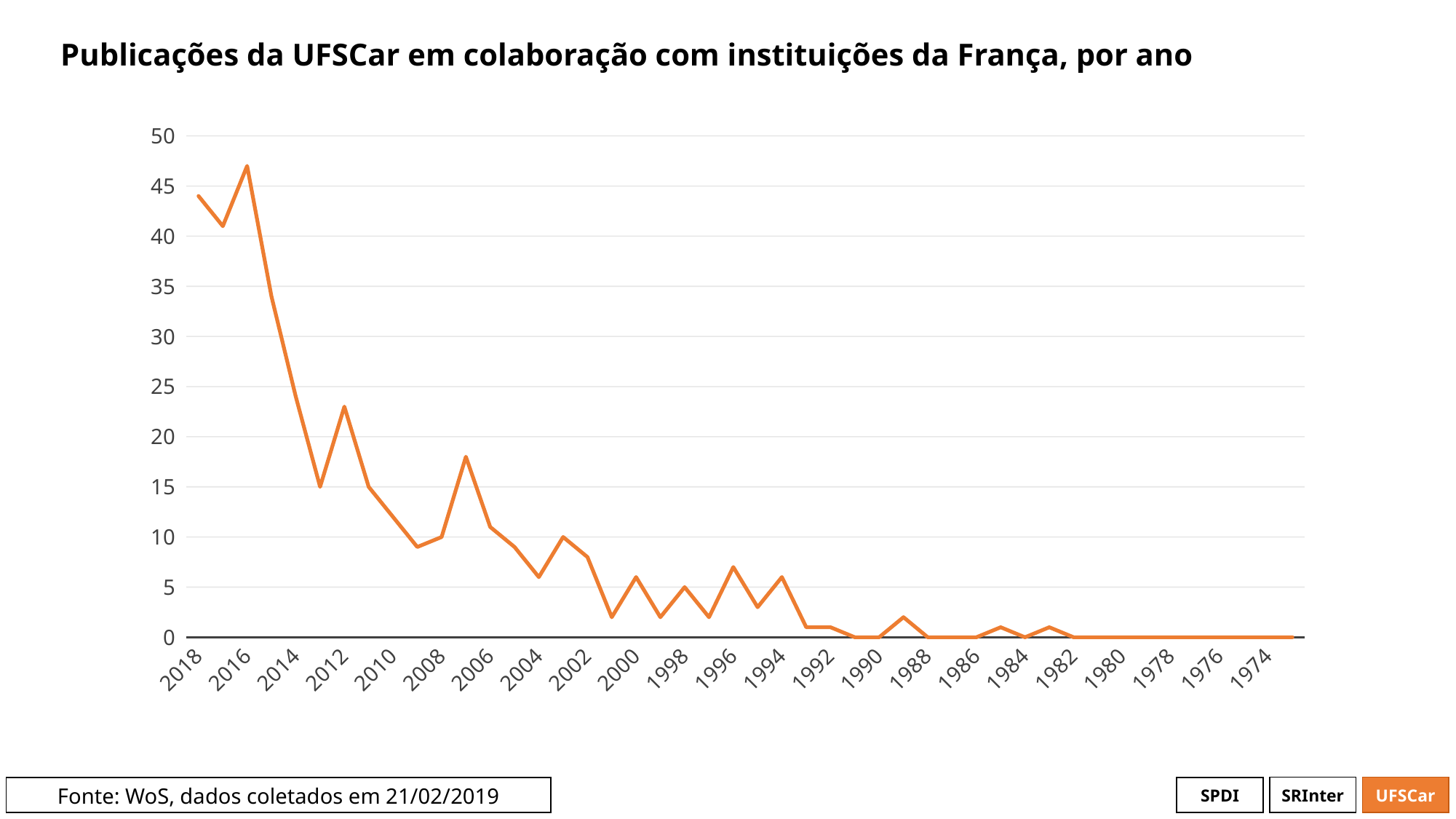
What kind of chart is shown on the slide? line chart Which year has the highest number of publications? 2016 Is the value for 2004 greater or less than 10? less Moving from left (2018) to right (1974) along the x axis, do the values generally rise or fall? fall Which year has the larger value, 2012 or 2010? 2012 What is the title of the chart? Publicações da UFSCar em colaboração com instituições da França, por ano Is the value for 2018 greater or less than 40? greater Is the value for 2010 greater or less than 15? less Which year has the larger value, 2018 or 2016? 2016